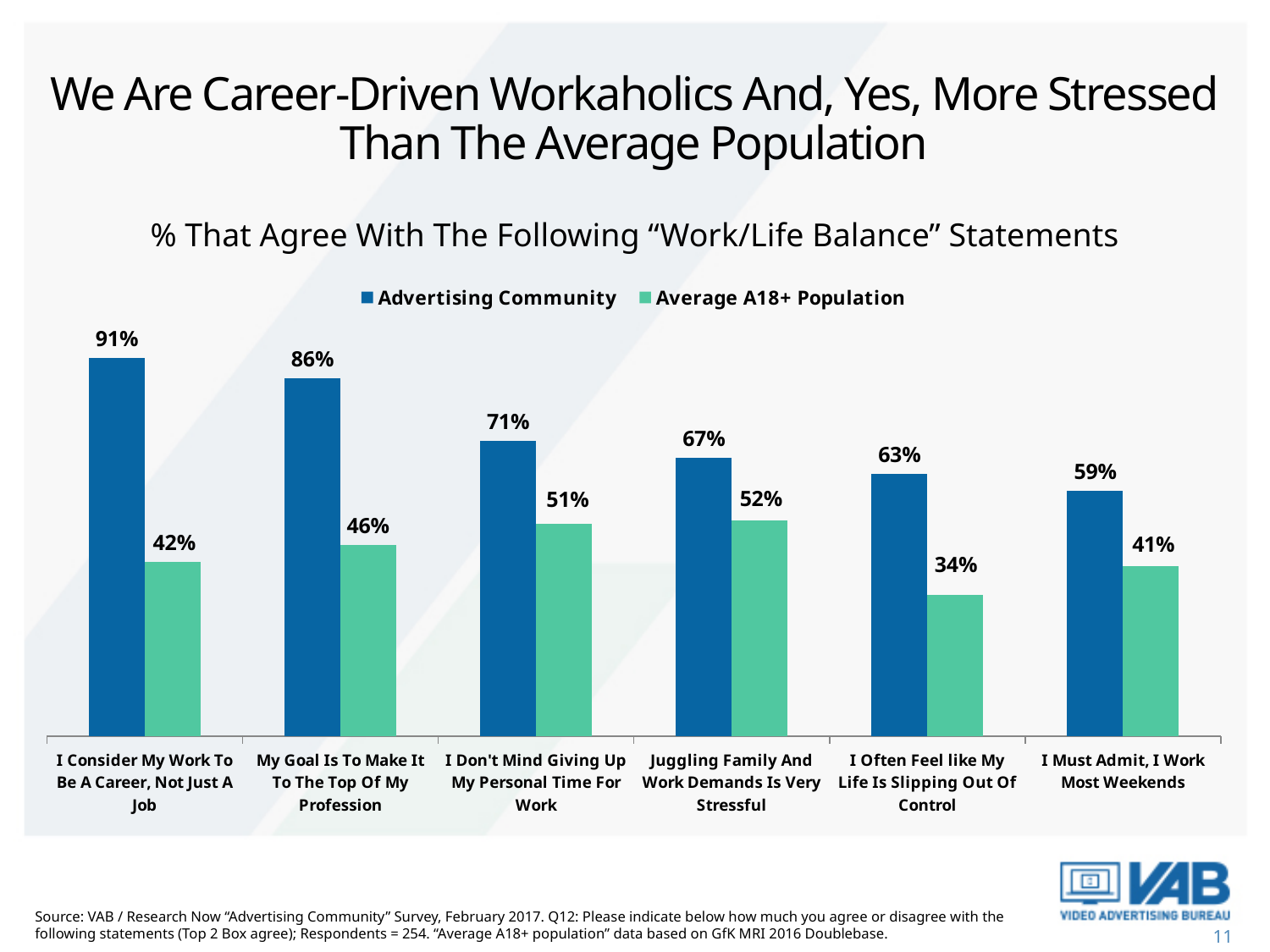
Do the Advertising Community values rise or fall from left to right across the statements? Fall Which statement has the highest Advertising Community value? I Consider My Work To Be A Career, Not Just A Job What percentage of the Advertising Community agrees with "I Consider My Work To Be A Career, Not Just A Job"? 91% What is the Average A18+ Population value for "Juggling Family And Work Demands Is Very Stressful"? 52% What kind of chart is shown on the slide? Bar chart What is the difference between the Advertising Community and Average A18+ Population values for "I Must Admit, I Work Most Weekends"? 18% What percentage of the Average A18+ Population agrees with "I Often Feel like My Life Is Slipping Out Of Control"? 34% What is the difference between the Advertising Community and Average A18+ Population values for "I Consider My Work To Be A Career, Not Just A Job"? 49% Which is larger: the Average A18+ Population value for "I Don't Mind Giving Up My Personal Time For Work" or for "My Goal Is To Make It To The Top Of My Profession"? I Don't Mind Giving Up My Personal Time For Work How many series does the legend list? 2 Which statement has the lowest Average A18+ Population value? I Often Feel like My Life Is Slipping Out Of Control How many statements are shown on the chart? 6